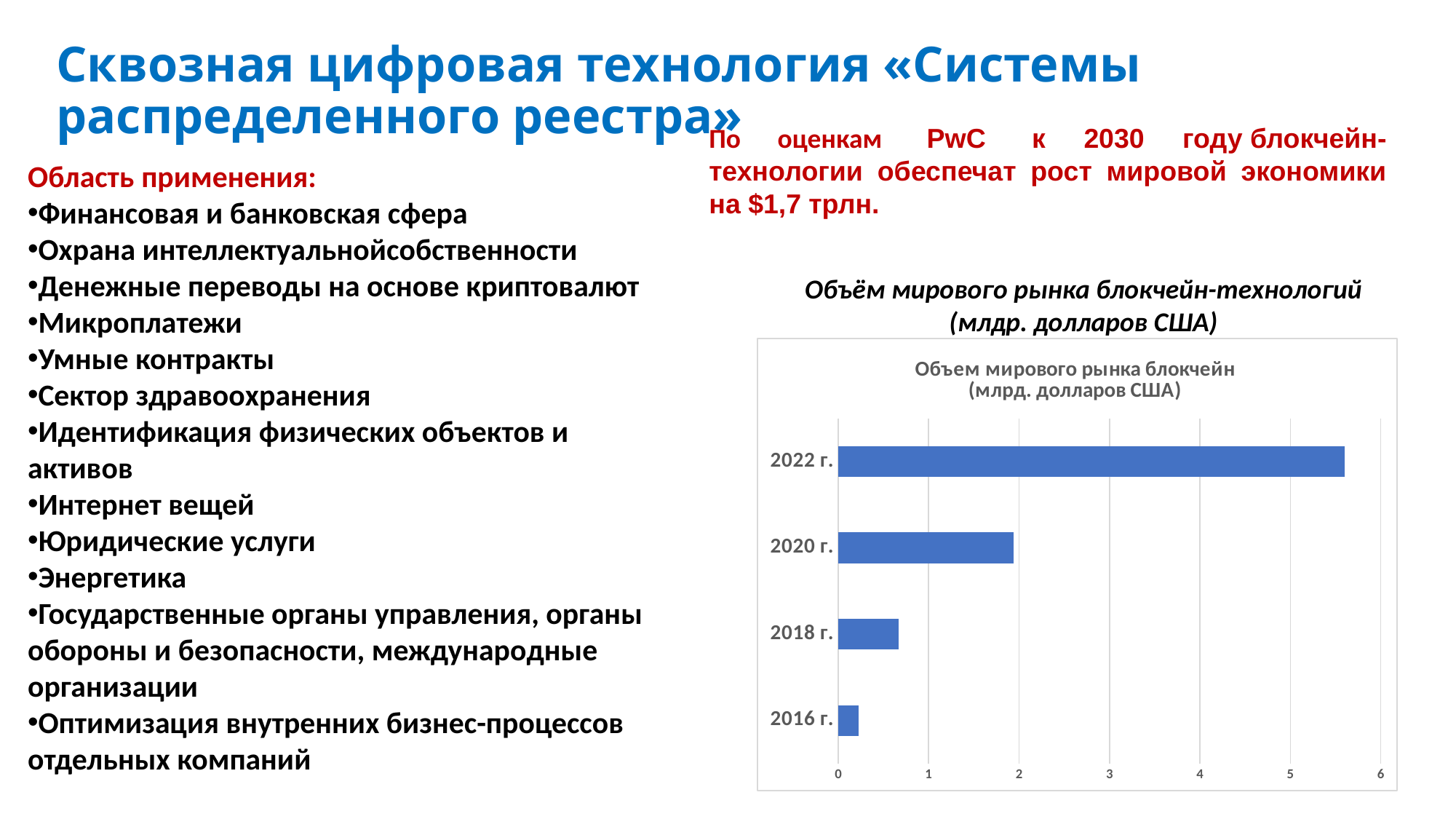
Is the value for 2018 г. greater or less than 1? less What is the maximum value shown on the horizontal axis of the chart? 6 What kind of chart is shown on the slide? bar chart Is the value for 2022 г. greater or less than 5? greater Which is larger, the value for 2020 г. or the value for 2018 г.? 2020 г. Which year has the highest value in the chart? 2022 г. What is the title shown inside the chart area? Объем мирового рынка блокчейн (млрд. долларов США) Which year has the lowest value in the chart? 2016 г. Do the values rise or fall from 2016 г. to 2022 г.? rise Is the value for 2020 г. greater or less than 1? greater How many categories (years) are plotted in the chart? 4